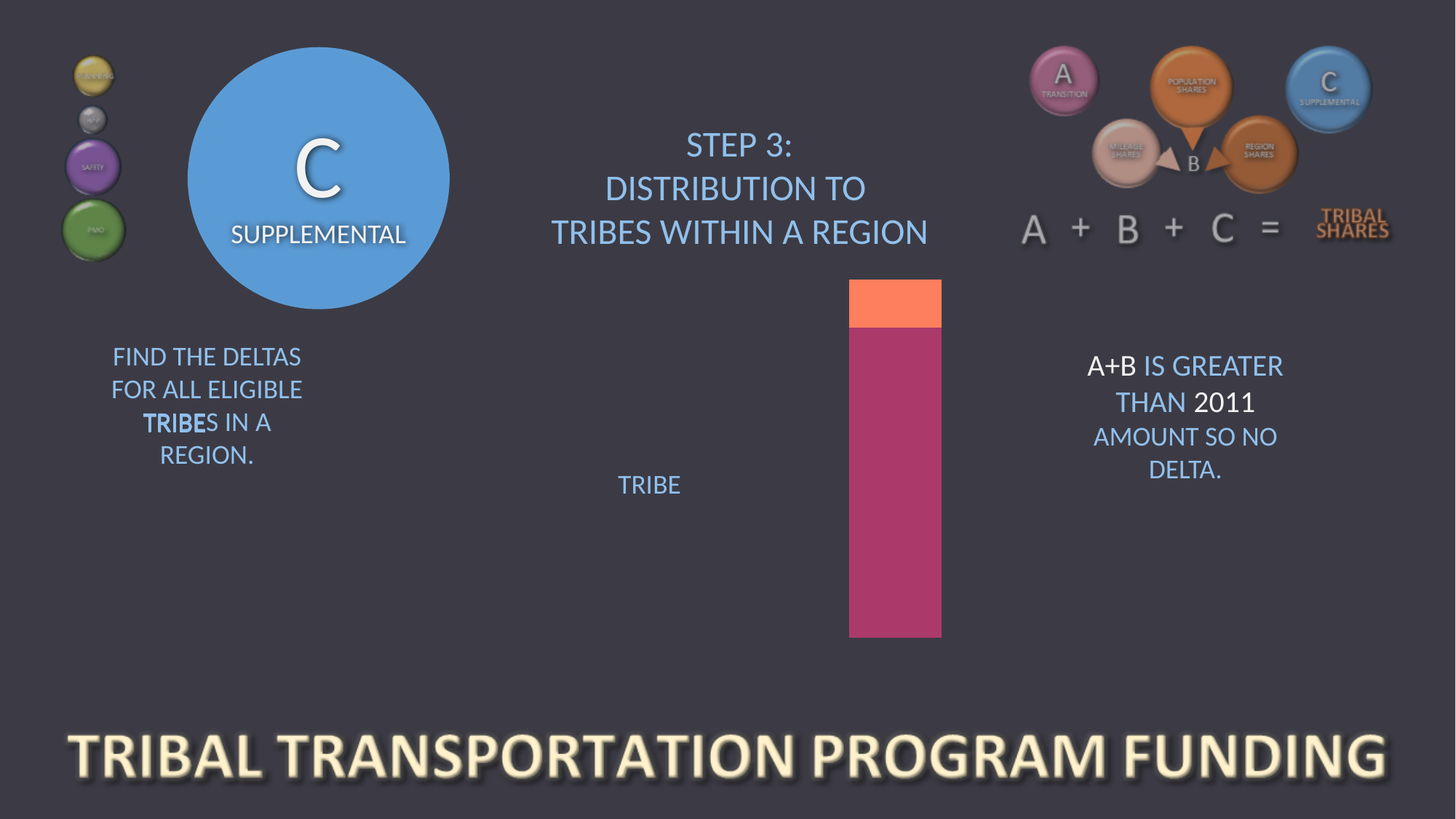
What colour is the top segment of the TRIBE bar? orange How many categories are plotted on the x axis of the bar chart? 1 Which segment of the TRIBE bar is larger, the orange segment on top or the magenta segment below? the magenta segment What kind of chart is shown in the middle of the slide? bar chart What is the label of the single category shown on the bar chart? TRIBE How many stacked segments make up the bar for TRIBE? 2